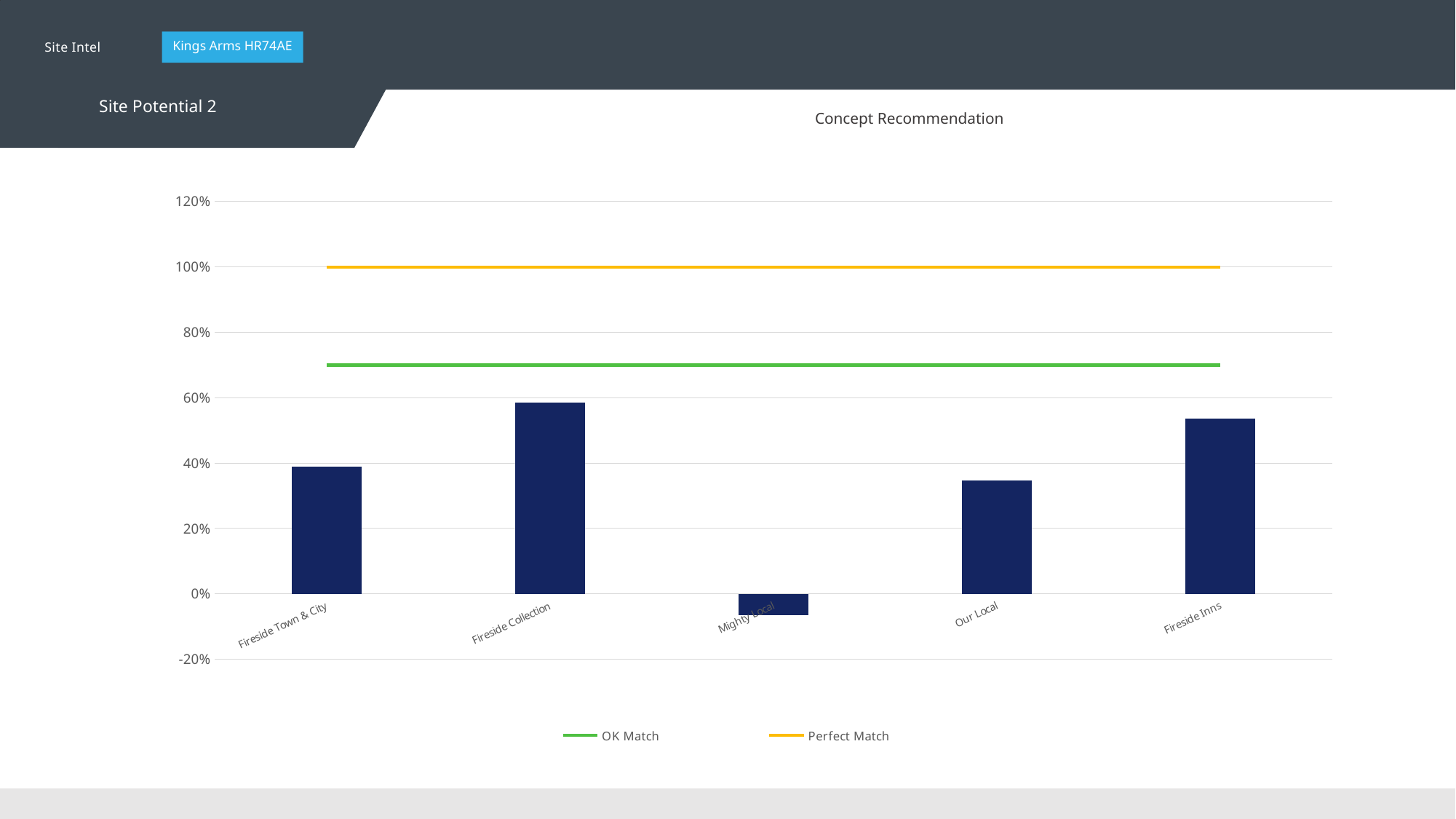
How many concept categories are plotted on the x axis? 5 Which concept has the lowest bar? Mighty Local Which concept has the highest bar? Fireside Collection How many series does the legend list? 2 Is the value for Fireside Collection greater or less than 60%? less Which has the larger value, Fireside Town & City or Our Local? Fireside Town & City At what level is the Perfect Match line drawn? 100% Is the value for Fireside Inns greater or less than 40%? greater What is the title of the chart? Concept Recommendation Is the value for Mighty Local greater or less than 0%? less What kind of chart is shown on the slide? combination bar and line chart Which has the larger value, Fireside Collection or Fireside Inns? Fireside Collection